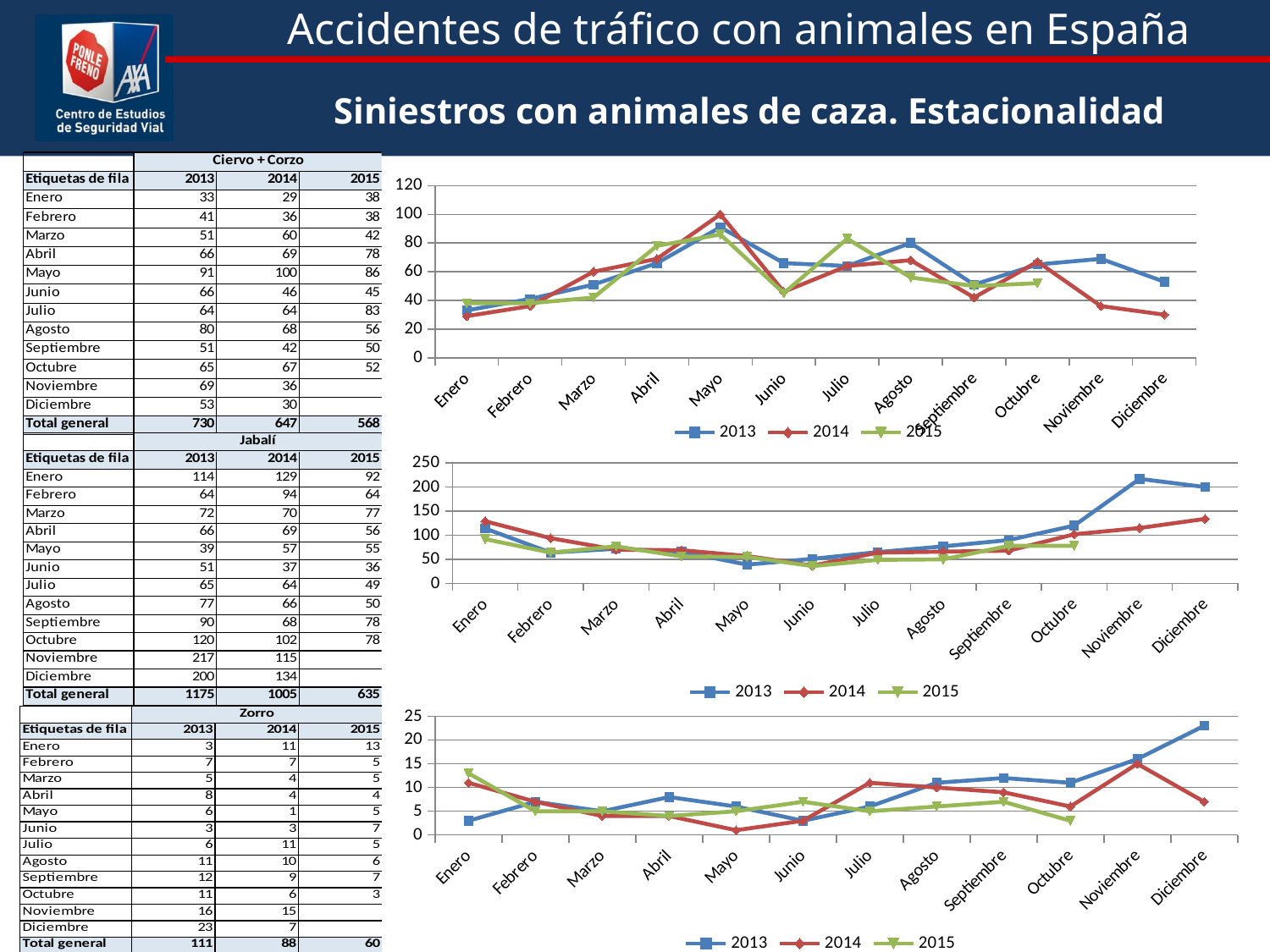
In the bottom chart, is the value for 2013 in Diciembre greater or less than 20? greater In the bottom chart, in which month does the 2014 series reach its lowest value? Mayo What kind of chart is the top chart on the slide? line chart In the bottom chart, what is the value for 2015 in Enero? 13 In the middle chart, is the value for 2013 in Noviembre greater or less than 200? greater In the top chart, in which month does the 2014 series reach its highest value? Mayo How many series does the legend of the middle chart list? 3 In the top chart, what is the value for 2014 in Mayo? 100 In the middle chart, does the 2013 series rise or fall from Octubre to Noviembre? rise In the top chart, what is the difference between the 2014 and 2013 values in Mayo? 9 In the middle chart, which series has the larger value in Enero, 2013 or 2014? 2014 How many categories are shown along the x axis of the bottom chart? 12